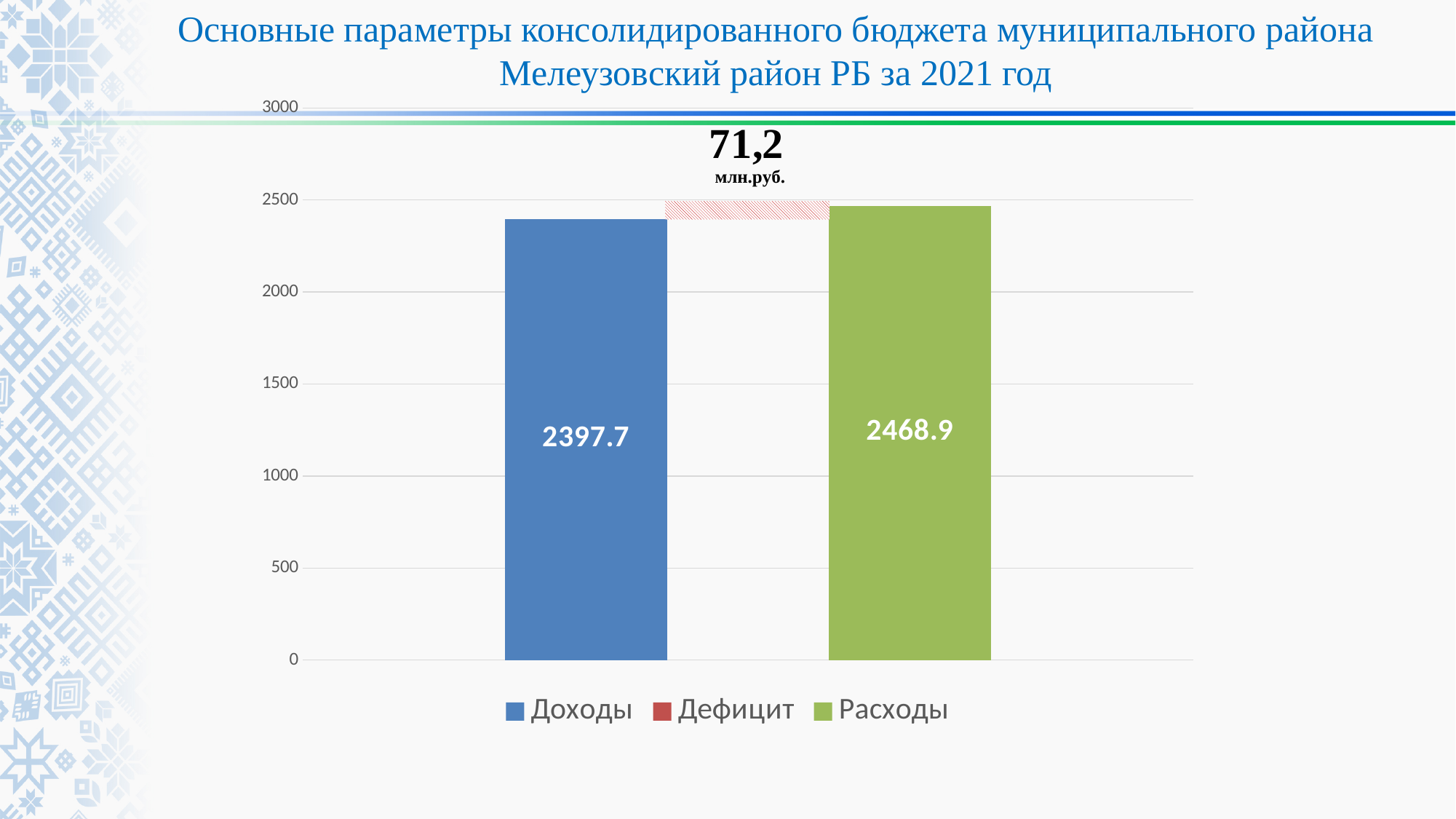
Is the value for Расходы greater or less than 2000? greater What is the value of the Доходы bar? 2397.7 Is the value for Доходы greater or less than 2500? less What is the difference between Расходы and Доходы? 71.2 What is the highest value shown on the vertical axis? 3000 What is the value of the Расходы bar? 2468.9 How many series does the legend list? 3 Which series has the lowest value on the chart? Дефицит What value is shown for the deficit (Дефицит) above the bars? 71,2 млн.руб. What kind of chart is shown on the slide? Bar chart Which legend entry is shown in green? Расходы Which is larger, Доходы or Расходы? Расходы